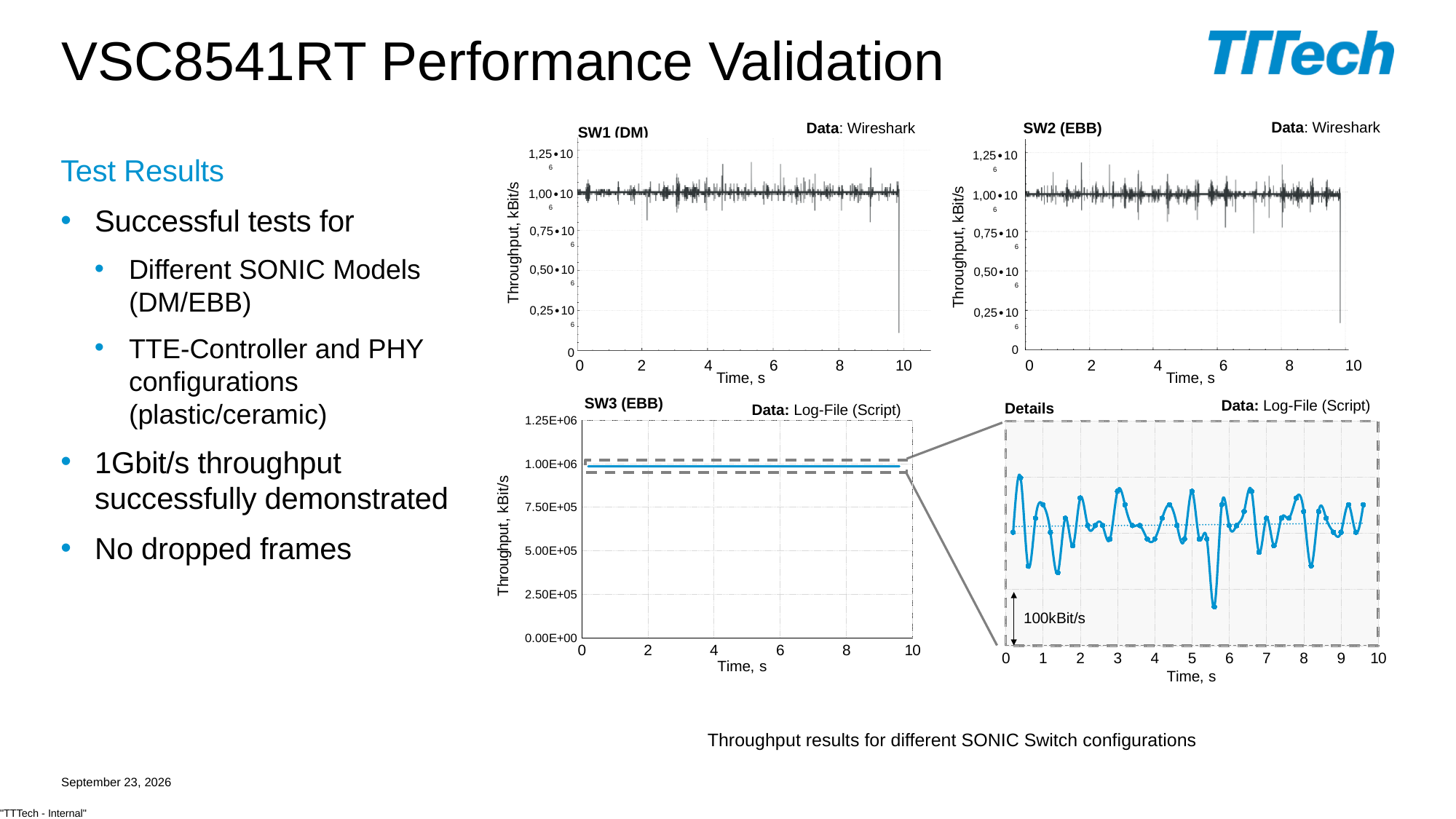
In the SW3 (EBB) chart, is the plotted throughput value greater or less than 1.25E+06? less What is the label of the y axis on the SW3 (EBB) chart? Throughput, kBit/s What data source is stated for the SW1 (DM) chart? Wireshark What is the highest tick value on the x axis of the SW3 (EBB) chart? 10 In the Details chart, what value does the vertical scale arrow represent? 100kBit/s What kind of chart is the SW3 (EBB) chart? line chart In the SW1 (DM) chart, is the typical throughput level greater or less than 0,50•10^6? greater In the SW2 (EBB) chart, is the typical throughput level greater or less than 1,25•10^6? less How many charts are shown on the slide? 4 In the SW3 (EBB) chart, does the throughput line rise, fall, or stay flat along the time axis? stay flat